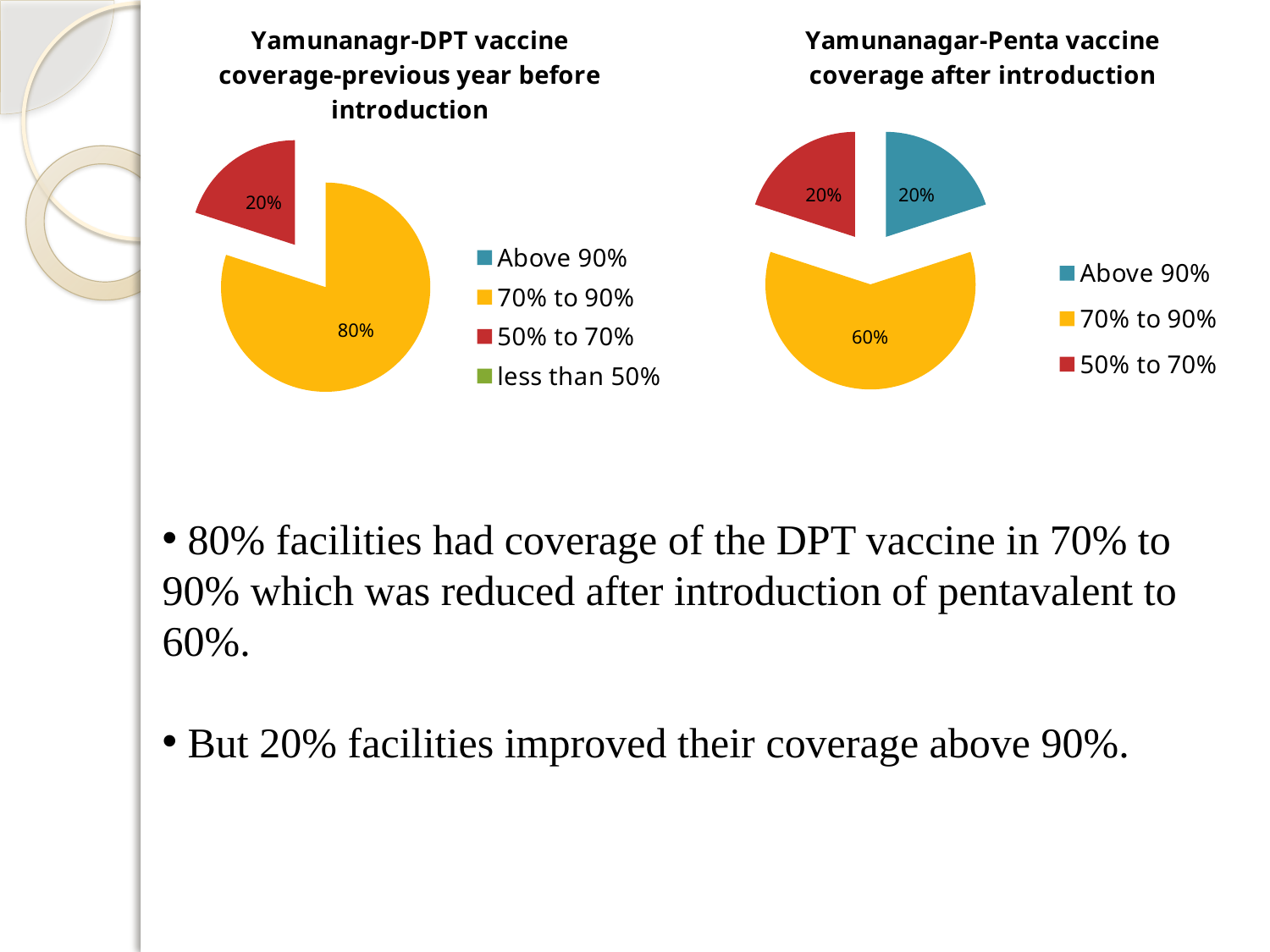
In the right chart (Yamunanagar-Penta vaccine coverage after introduction), which category has the largest slice? 70% to 90% In the right chart (Yamunanagar-Penta vaccine coverage after introduction), what share of facilities had coverage above 90%? 20% In the left chart (Yamunanagr-DPT vaccine coverage-previous year before introduction), what is the difference between the 70% to 90% slice and the 50% to 70% slice? 60% In the left chart (Yamunanagr-DPT vaccine coverage-previous year before introduction), what share of facilities had coverage of 50% to 70%? 20% In the right chart (Yamunanagar-Penta vaccine coverage after introduction), what share of facilities had coverage of 70% to 90%? 60% How many entries does the legend of the left chart (Yamunanagr-DPT vaccine coverage-previous year before introduction) list? 4 In the left chart (Yamunanagr-DPT vaccine coverage-previous year before introduction), what share of facilities had coverage of 70% to 90%? 80% What is the difference between the 70% to 90% share in the left chart (DPT, before introduction) and the 70% to 90% share in the right chart (Penta, after introduction)? 20% How many entries does the legend of the right chart (Yamunanagar-Penta vaccine coverage after introduction) list? 3 In the left chart (Yamunanagr-DPT vaccine coverage-previous year before introduction), which category has the largest slice? 70% to 90% In the right chart (Yamunanagar-Penta vaccine coverage after introduction), which is larger: the 70% to 90% slice or the 50% to 70% slice? 70% to 90% What type of chart is used for the Yamunanagar-Penta vaccine coverage after introduction? Pie chart